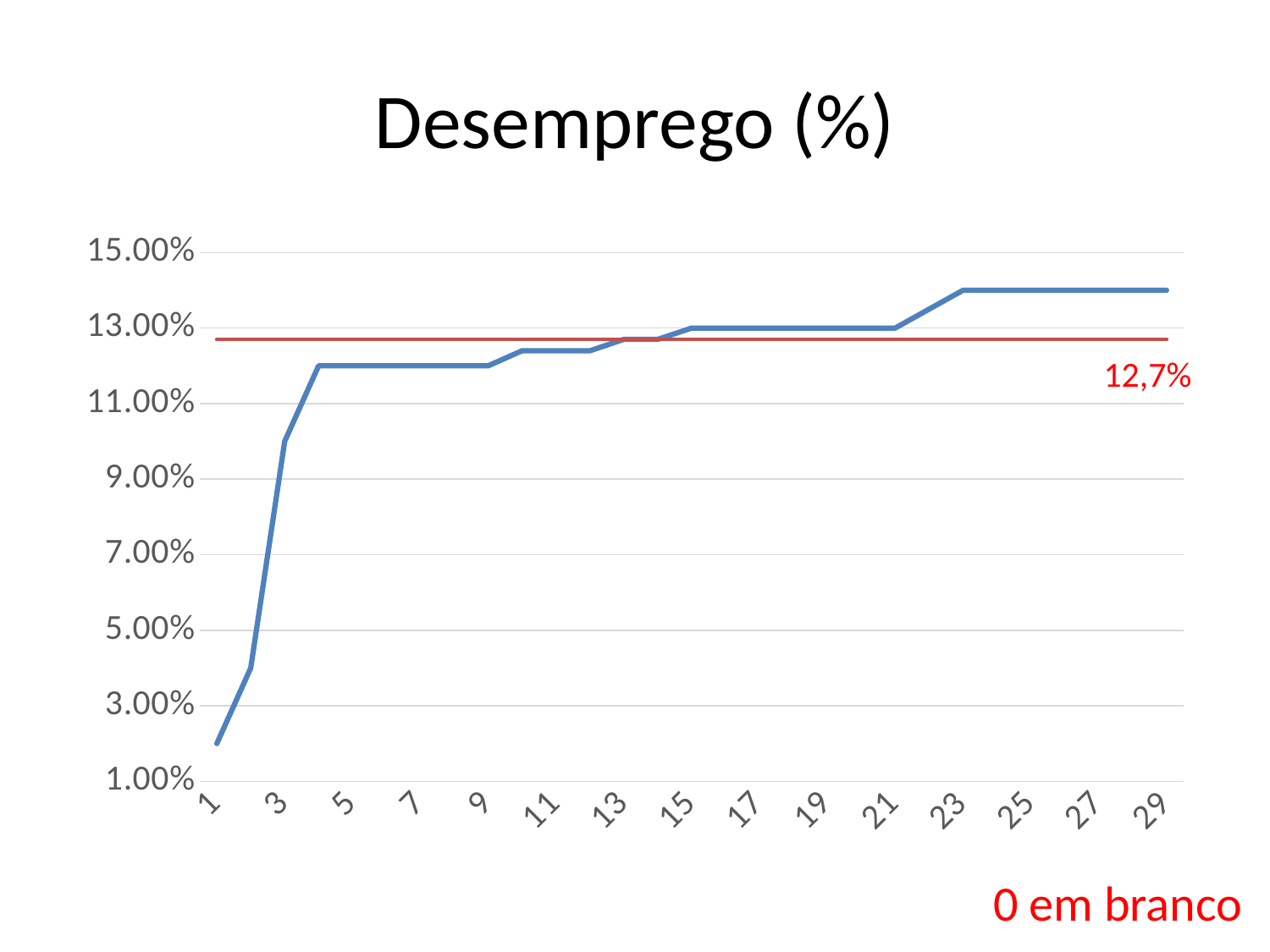
Is the value at point 25 greater or less than 15.00%? less Is the value at point 3 greater or less than 9.00%? greater Which is larger, the value at point 1 or the value at point 29? point 29 What is the value of the blue line at point 19? 13.00% Is the value at point 1 greater or less than 3.00%? less What value is labelled on the red horizontal reference line? 12,7% What is the value of the blue line at point 17? 13.00% What is the title of the chart? Desemprego (%) What kind of chart is shown on the slide? line chart Do the values of the blue line generally rise or fall from left to right along the x axis? rise